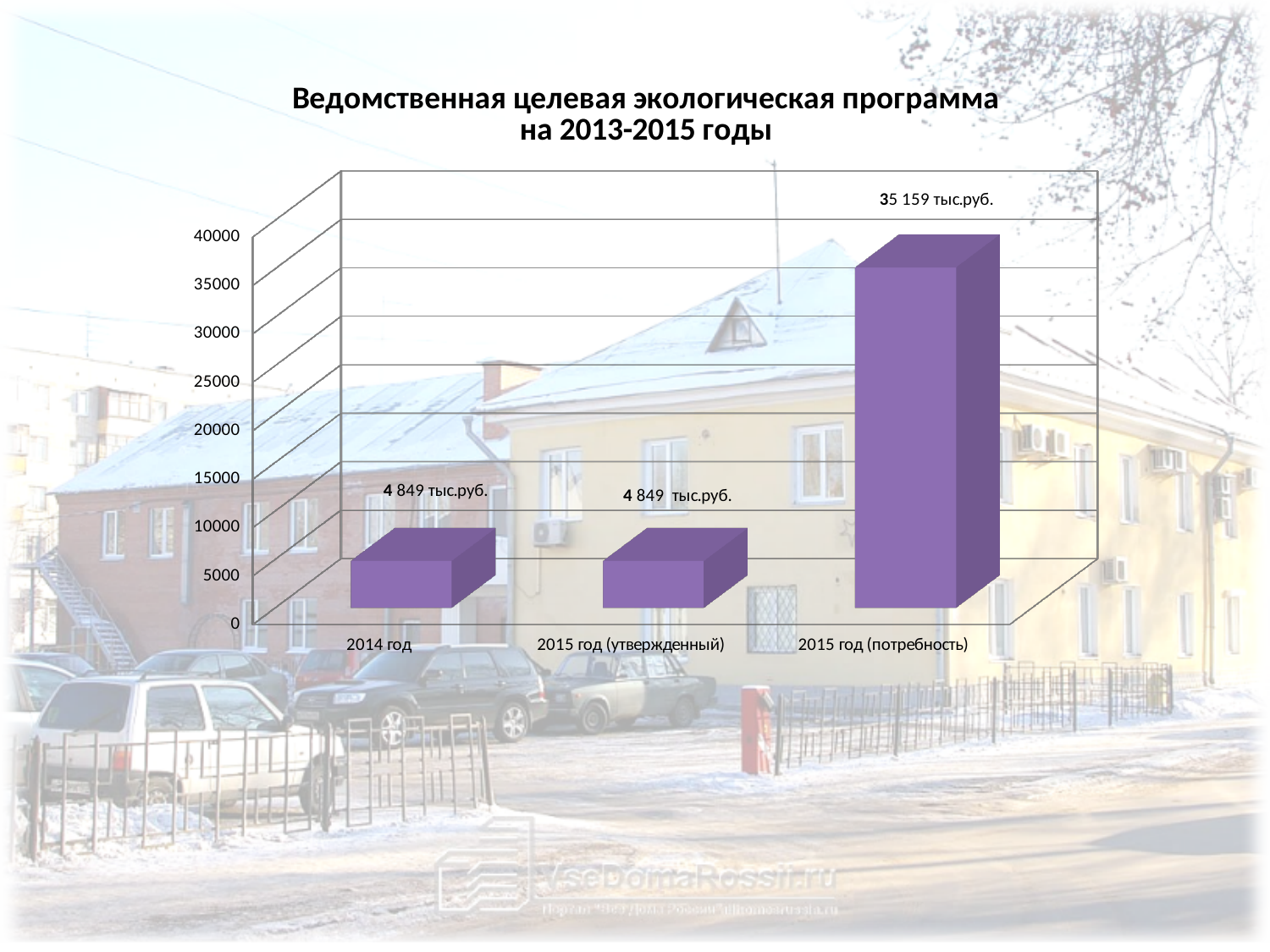
How many categories are shown on the x axis? 3 What is the value for 2015 год (утвержденный)? 4 849 тыс.руб. What colour are the bars in the chart? purple What kind of chart is shown on the slide? bar chart Is the value for 2014 год greater or less than 10000? less What is the title of the chart? Ведомственная целевая экологическая программа на 2013-2015 годы Which category has the highest value? 2015 год (потребность) What is the value for 2015 год (потребность)? 35 159 тыс.руб. What is the difference between the values for 2015 год (потребность) and 2015 год (утвержденный)? 30 310 тыс.руб. What is the value for 2014 год? 4 849 тыс.руб. Which is larger, the value for 2015 год (потребность) or the value for 2014 год? 2015 год (потребность) Is the value for 2015 год (потребность) greater or less than 30000? greater